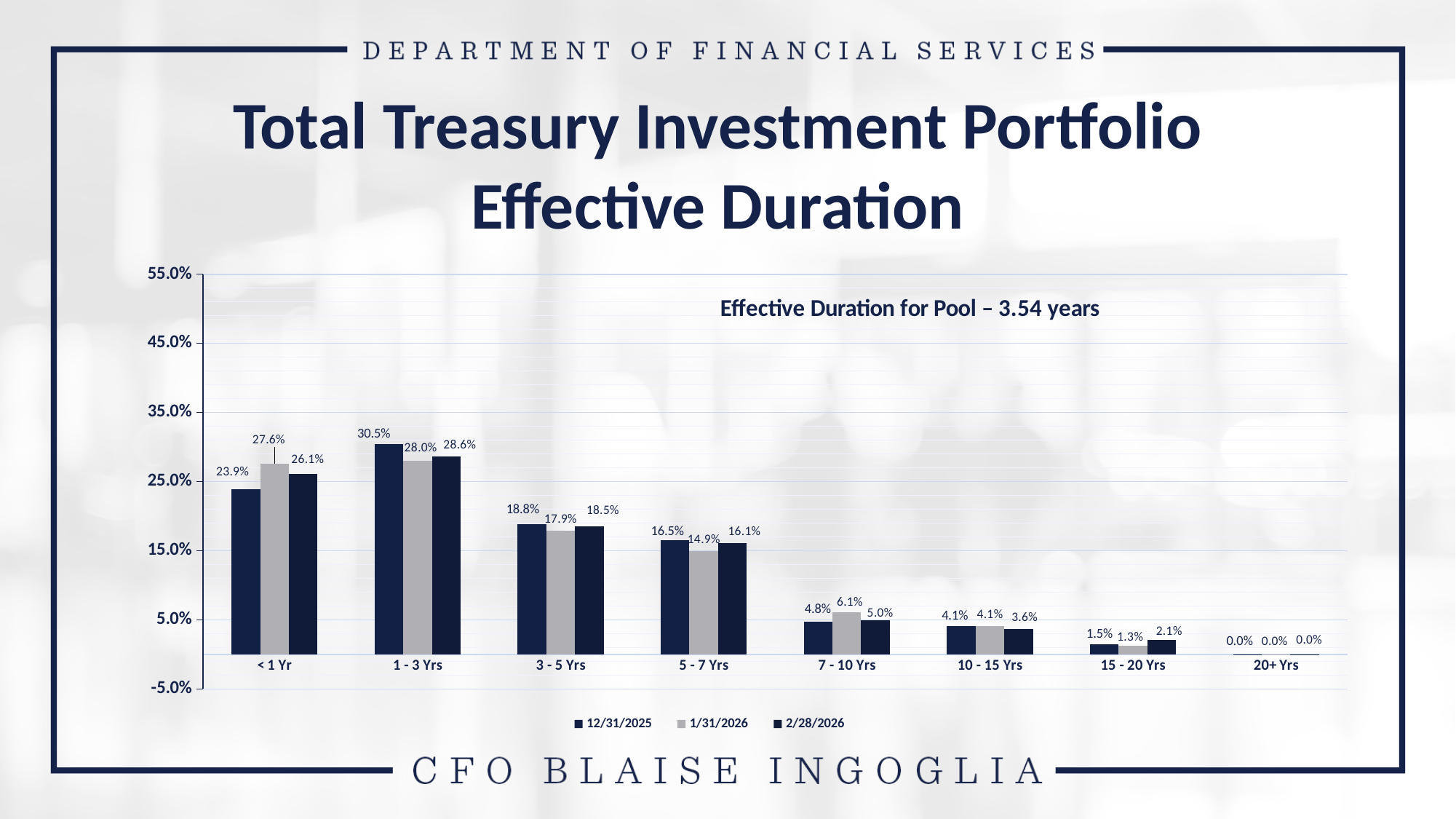
Which category has the highest value in the 2/28/2026 series? 1 - 3 Yrs Do the 2/28/2026 values generally rise or fall from the 1 - 3 Yrs category to the 20+ Yrs category? Fall How many categories are shown on the x axis? 8 What is the value for the 7 - 10 Yrs category in the 2/28/2026 series? 5.0% What kind of chart is shown on the slide? Bar chart What effective duration for the pool is stated on the chart? 3.54 years Which is larger for the 3 - 5 Yrs category: the 12/31/2025 value or the 1/31/2026 value? 12/31/2025 What is the value for the < 1 Yr category in the 1/31/2026 series? 27.6% What is the difference between the 12/31/2025 and 1/31/2026 values for the < 1 Yr category? 3.7% How many series does the legend list? 3 What is the value for the 1 - 3 Yrs category in the 12/31/2025 series? 30.5% Which category has the lowest value in the 12/31/2025 series? 20+ Yrs